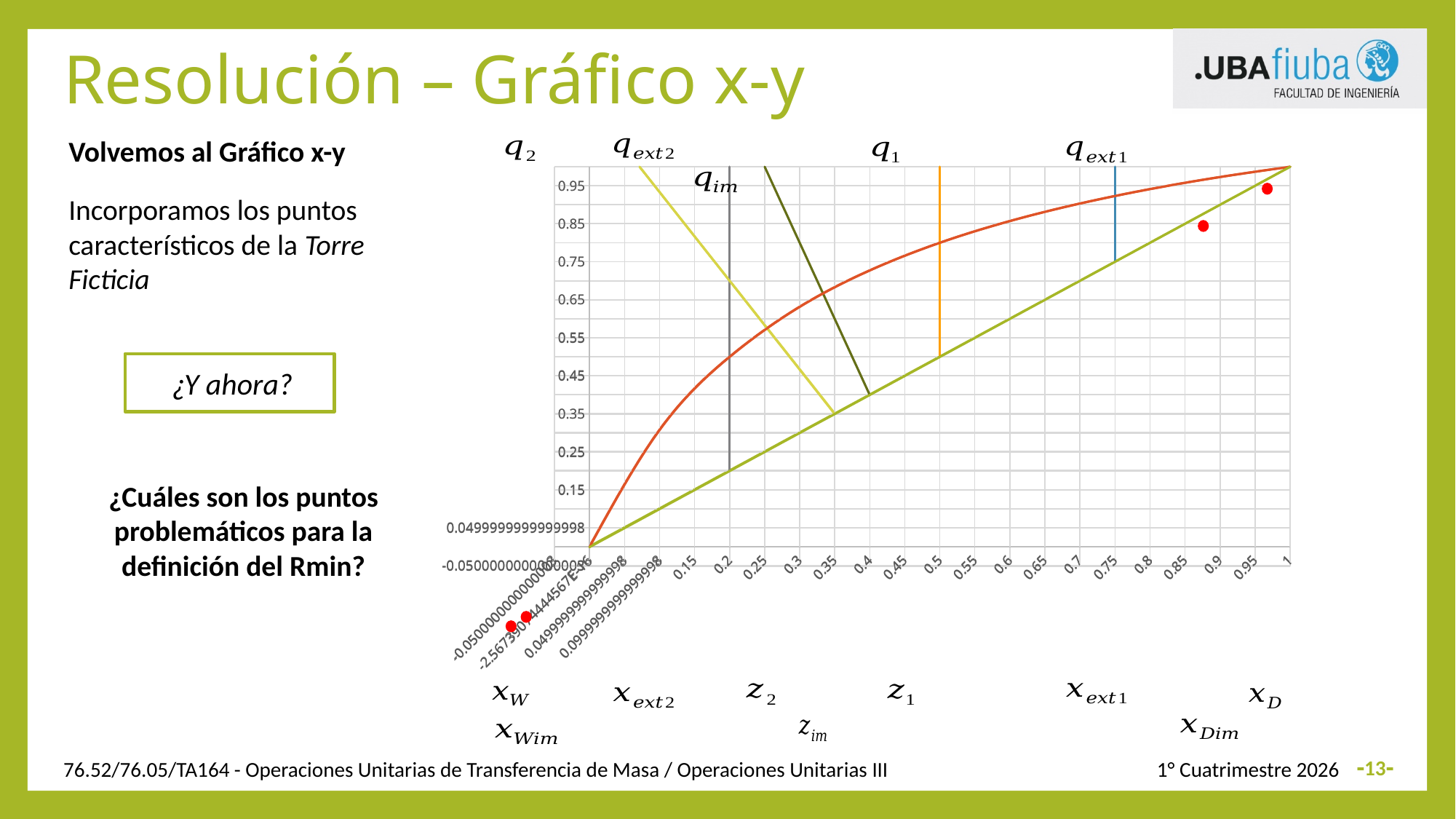
Is the x position of the vertical orange q1 line greater or less than 0.4? greater Is the x position of the vertical blue qext1 line greater or less than 0.7? greater Does the curved red line rise or fall as x increases from 0 to 1? rises How many red dots are plotted on the chart? 4 Is the x position of the vertical grey qim line greater or less than 0.3? less What kind of chart is shown on the slide? line chart What is the highest tick value shown on the x axis? 1 Which is higher at x = 0.5: the curved red line or the green diagonal line? the curved red line What colour is the straight diagonal line running from the origin to the top-right corner? green How many q-lines are labelled above the chart (q2, qext2, qim, q1, qext1)? 5